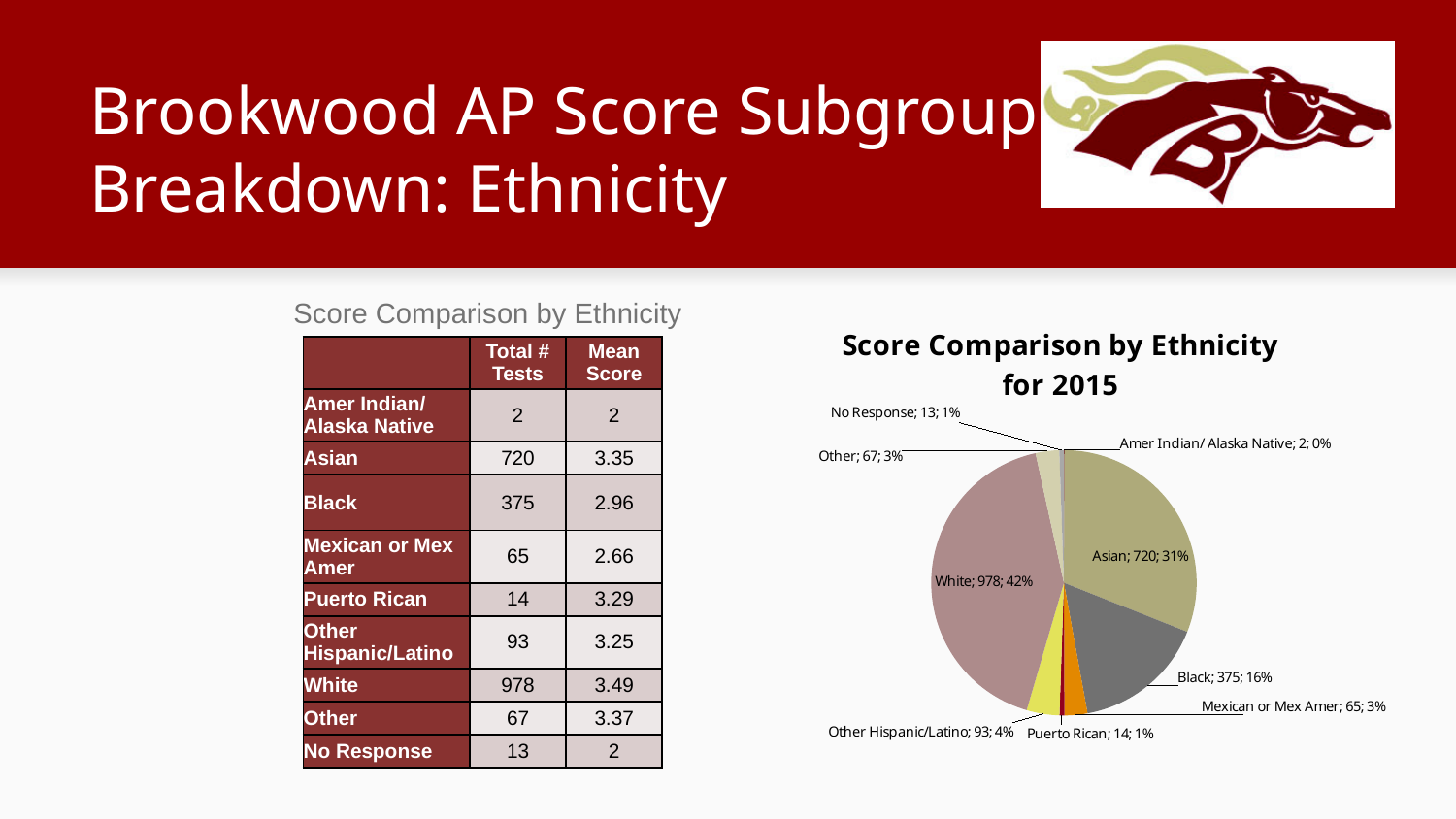
What percentage share of the pie does Asian represent? 31% What is the difference between the values for White and Asian in the pie chart? 258 Which category has the smallest slice in the pie chart? Amer Indian/ Alaska Native Which category has the largest slice in the pie chart? White Which is larger in the pie chart, Other Hispanic/Latino or Other? Other Hispanic/Latino What percentage share of the pie does White represent? 42% What is the value shown for Asian in the pie chart? 720 What is the title of the chart? Score Comparison by Ethnicity for 2015 What is the value shown for White in the pie chart? 978 What is the value shown for Black in the pie chart? 375 What kind of chart is shown on the slide? pie chart How many slices does the pie chart have? 9